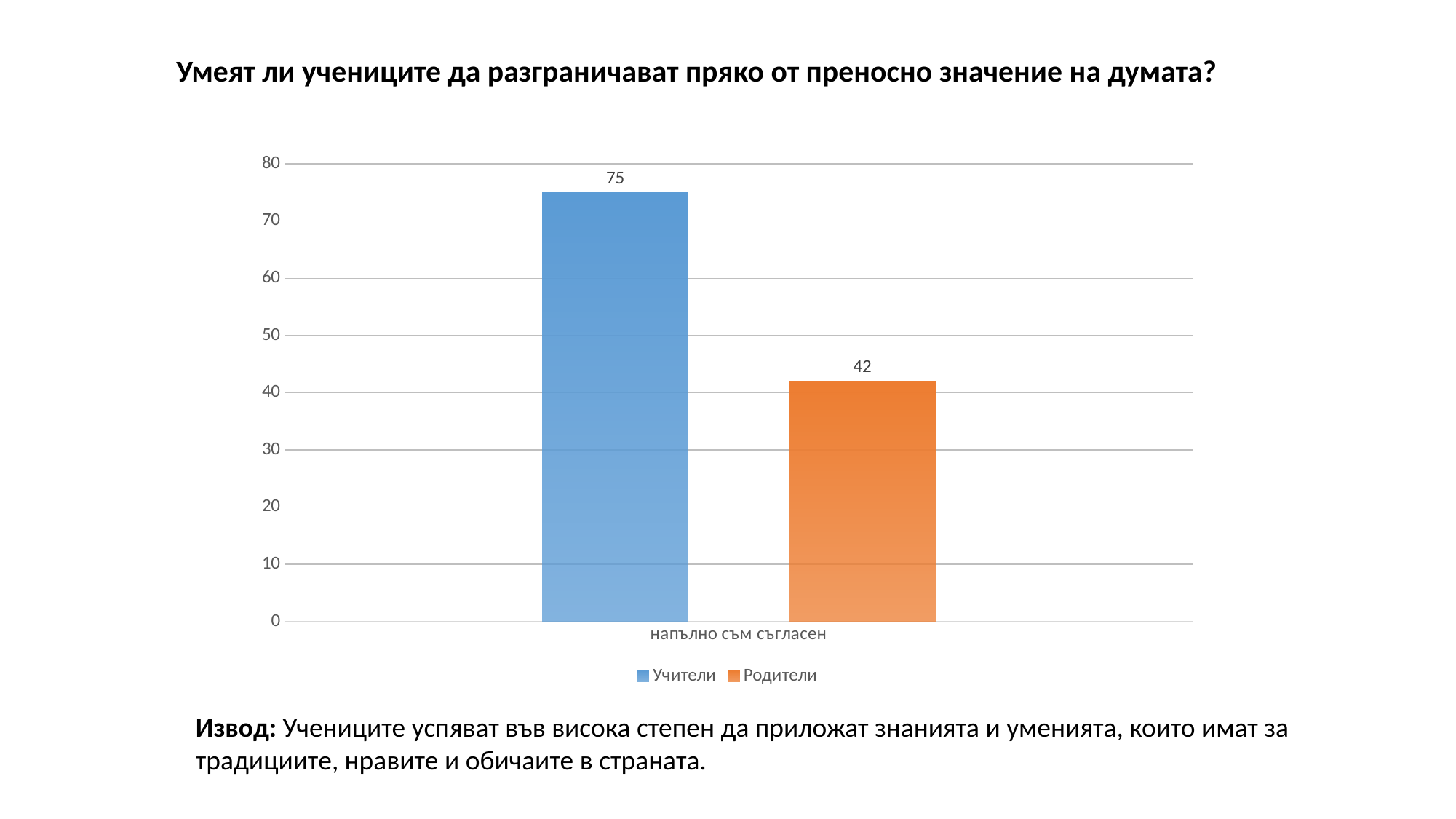
Is the value for Учители greater or less than 70? greater Which series has the lowest value? Родители What is the category label on the x axis? напълно съм съгласен Is the value for Родители greater or less than 50? less What is the difference between the values for Учители and Родители? 33 What kind of chart is shown on the slide? bar chart How many categories are shown on the x axis? 1 Which series has the higher value, Учители or Родители? Учители What is the value for Родители? 42 What is the value for Учители? 75 How many series does the legend list? 2 What colour is the bar for Родители? orange